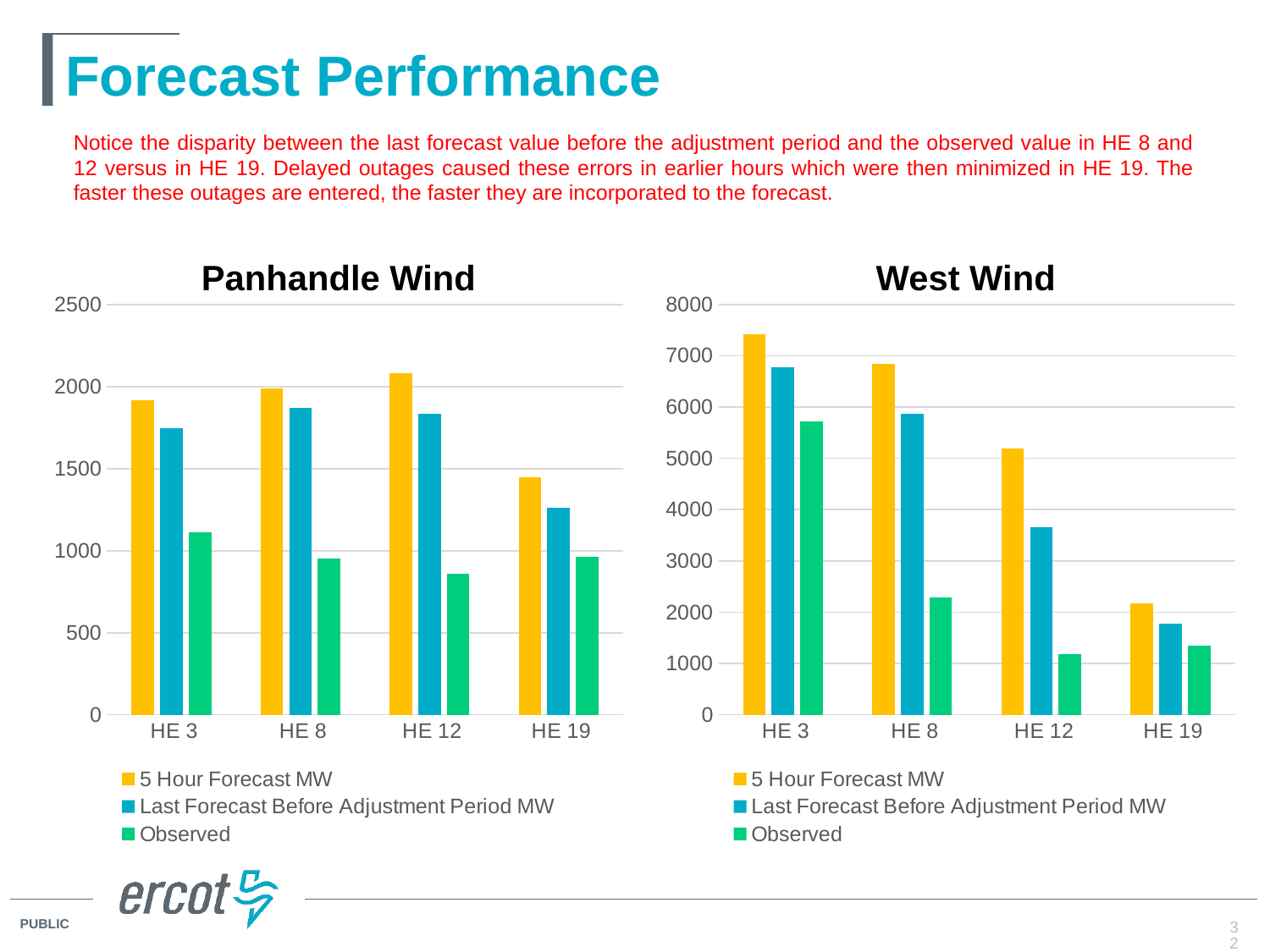
How many hour categories are shown on the x axis of the Panhandle Wind chart? 4 In the Panhandle Wind chart, which is larger for HE 3: the Last Forecast Before Adjustment Period MW or the Observed value? Last Forecast Before Adjustment Period MW In the Panhandle Wind chart, which hour has the highest 5 Hour Forecast MW value? HE 12 In the West Wind chart, is the Last Forecast Before Adjustment Period MW value for HE 12 greater or less than 4000? less In the Panhandle Wind chart, is the 5 Hour Forecast MW value for HE 12 greater or less than 2000? greater In the West Wind chart, do the 5 Hour Forecast MW values rise or fall from HE 3 to HE 19? fall In the Panhandle Wind chart, which hour has the lowest Observed value? HE 12 How many series does the legend of the West Wind chart list? 3 In the West Wind chart, which is larger for HE 19: the 5 Hour Forecast MW or the Observed value? 5 Hour Forecast MW In the West Wind chart, which hour has the highest 5 Hour Forecast MW value? HE 3 In the West Wind chart, is the Observed value for HE 8 greater or less than 2000? greater